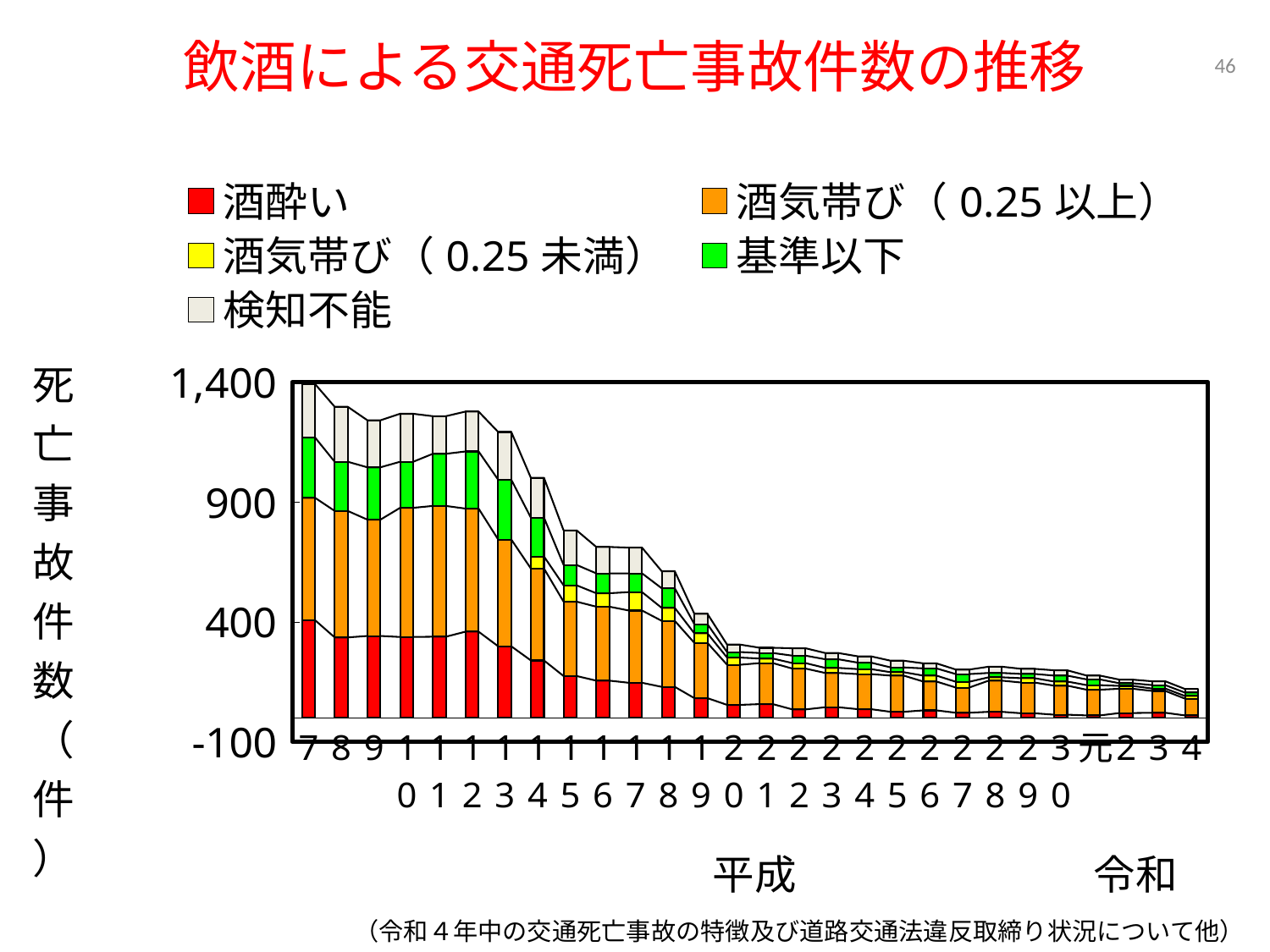
Is the total value for 平成10 greater or less than 900? greater What kind of chart is shown on the slide? stacked bar chart How many years (bars) are plotted on the x axis? 28 Which has a larger total value, 平成7 or 令和4? 平成7 Do the total values rise or fall along the x axis from 平成7 to 令和4? fall Is the total value for 平成7 greater or less than 900? greater Is the total value for 令和4 greater or less than 400? less How many series does the legend list? 5 Which year has the highest total number of fatal accidents? 平成7 What is the title of the chart? 飲酒による交通死亡事故件数の推移 Which colour represents 酒酔い in the chart? red